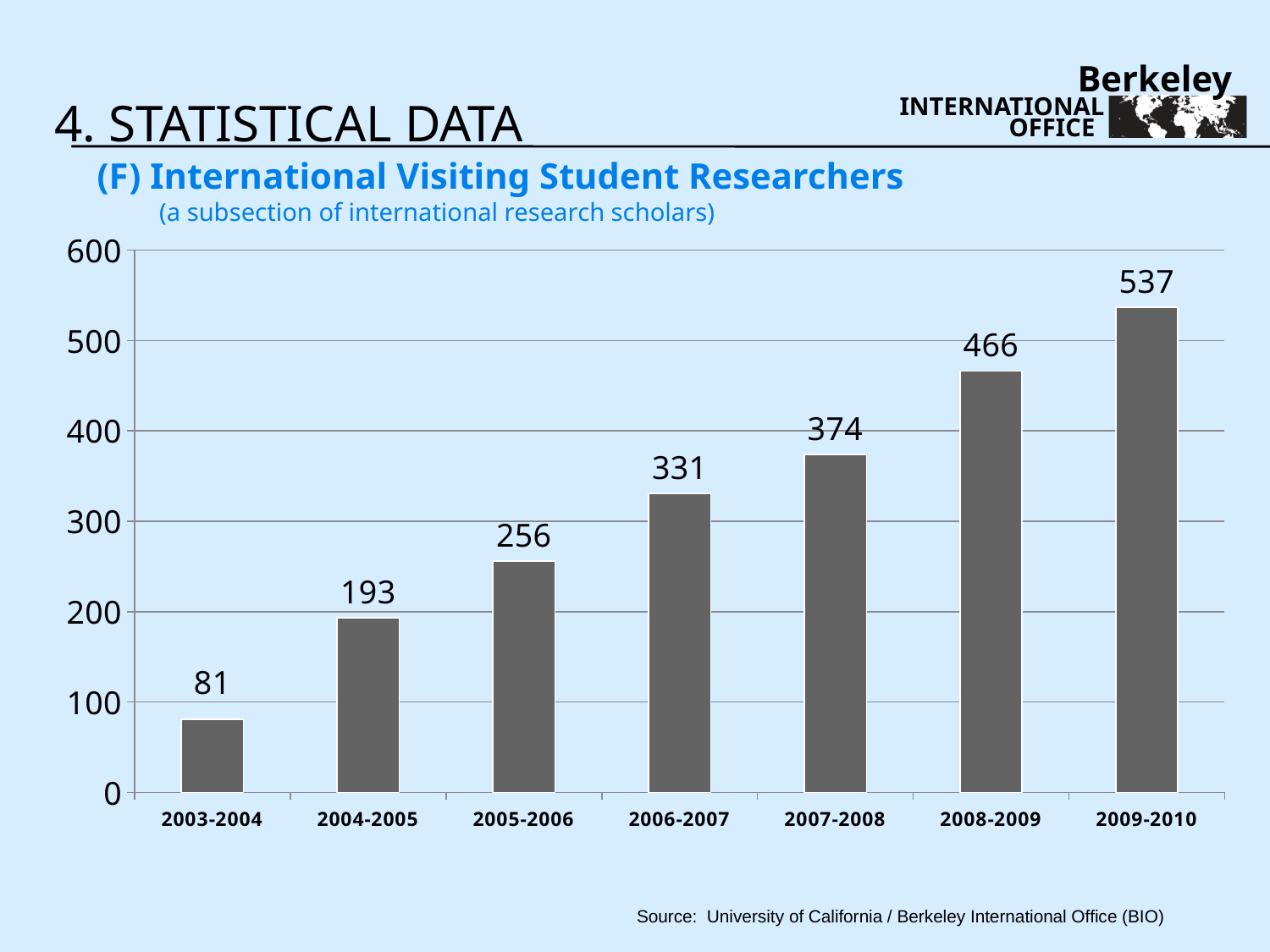
Which is larger, the value for 2007-2008 or the value for 2006-2007? 2007-2008 Do the values rise or fall from 2003-2004 to 2009-2010? rise How many years are shown on the x axis? 7 What kind of chart is shown on the slide? bar chart Is the value for 2008-2009 greater or less than 500? less What is the value for 2009-2010? 537 What is the value for 2003-2004? 81 What is the difference between the values for 2009-2010 and 2008-2009? 71 Which year has the lowest value? 2003-2004 What is the value for 2006-2007? 331 What is the difference between the values for 2005-2006 and 2004-2005? 63 Which year has the highest value? 2009-2010